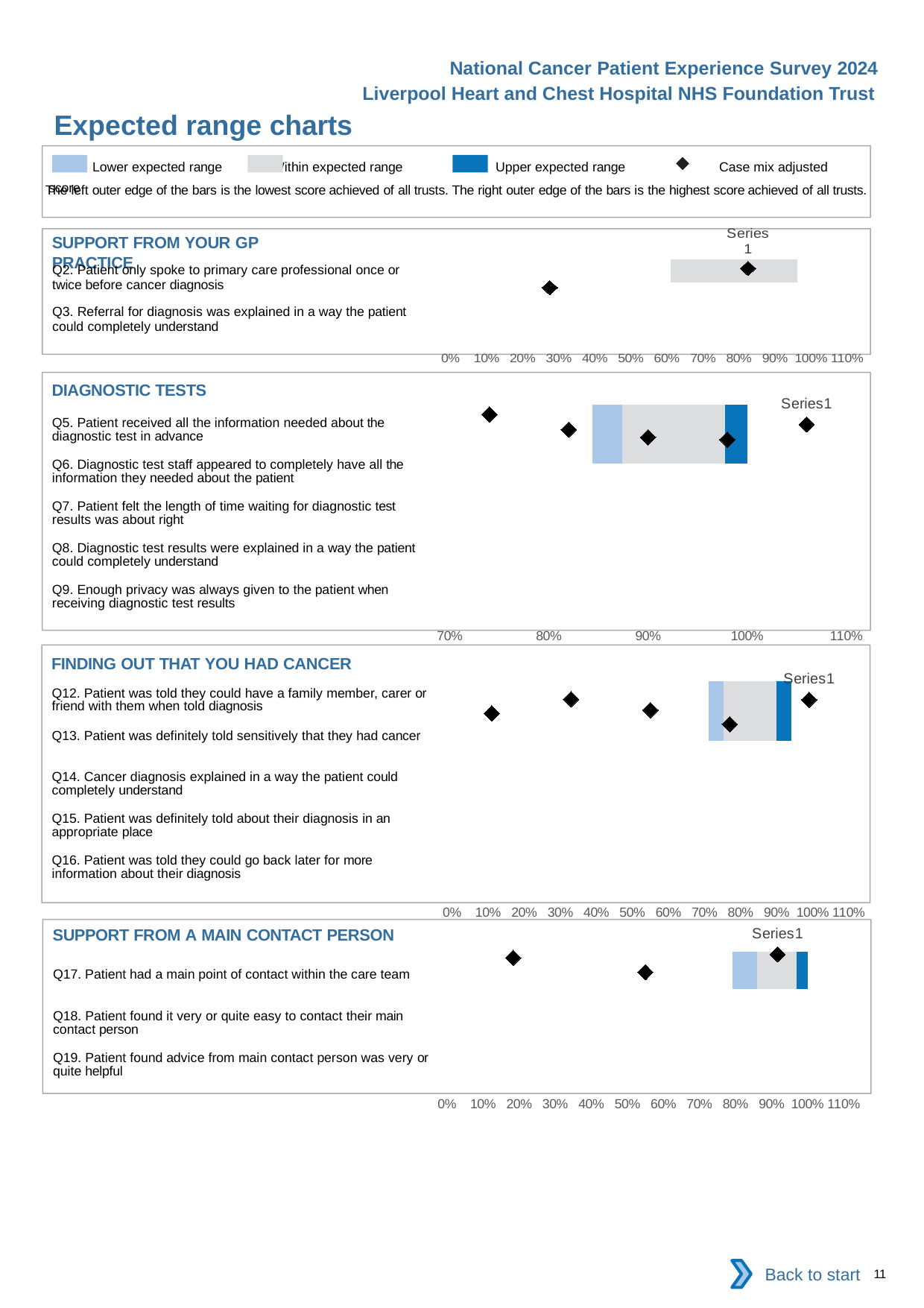
How many questions are listed in the SUPPORT FROM YOUR GP PRACTICE chart? 2 In the legend at the top of the slide, what does the black diamond marker represent? Case mix adjusted score In the SUPPORT FROM YOUR GP PRACTICE chart, is the diamond marker that sits inside the grey bar greater or less than 50%? greater What is the lowest tick label on the x axis of the DIAGNOSTIC TESTS chart? 70% How many questions are listed in the SUPPORT FROM A MAIN CONTACT PERSON chart? 3 How many questions are listed in the FINDING OUT THAT YOU HAD CANCER chart? 5 In the SUPPORT FROM A MAIN CONTACT PERSON chart, is the left edge of the expected range bar greater or less than 50%? greater In the legend at the top of the slide, what does the dark blue colour represent? Upper expected range What is the highest tick label on the x axis of the SUPPORT FROM YOUR GP PRACTICE chart? 110% What kind of chart is the DIAGNOSTIC TESTS chart? bar chart